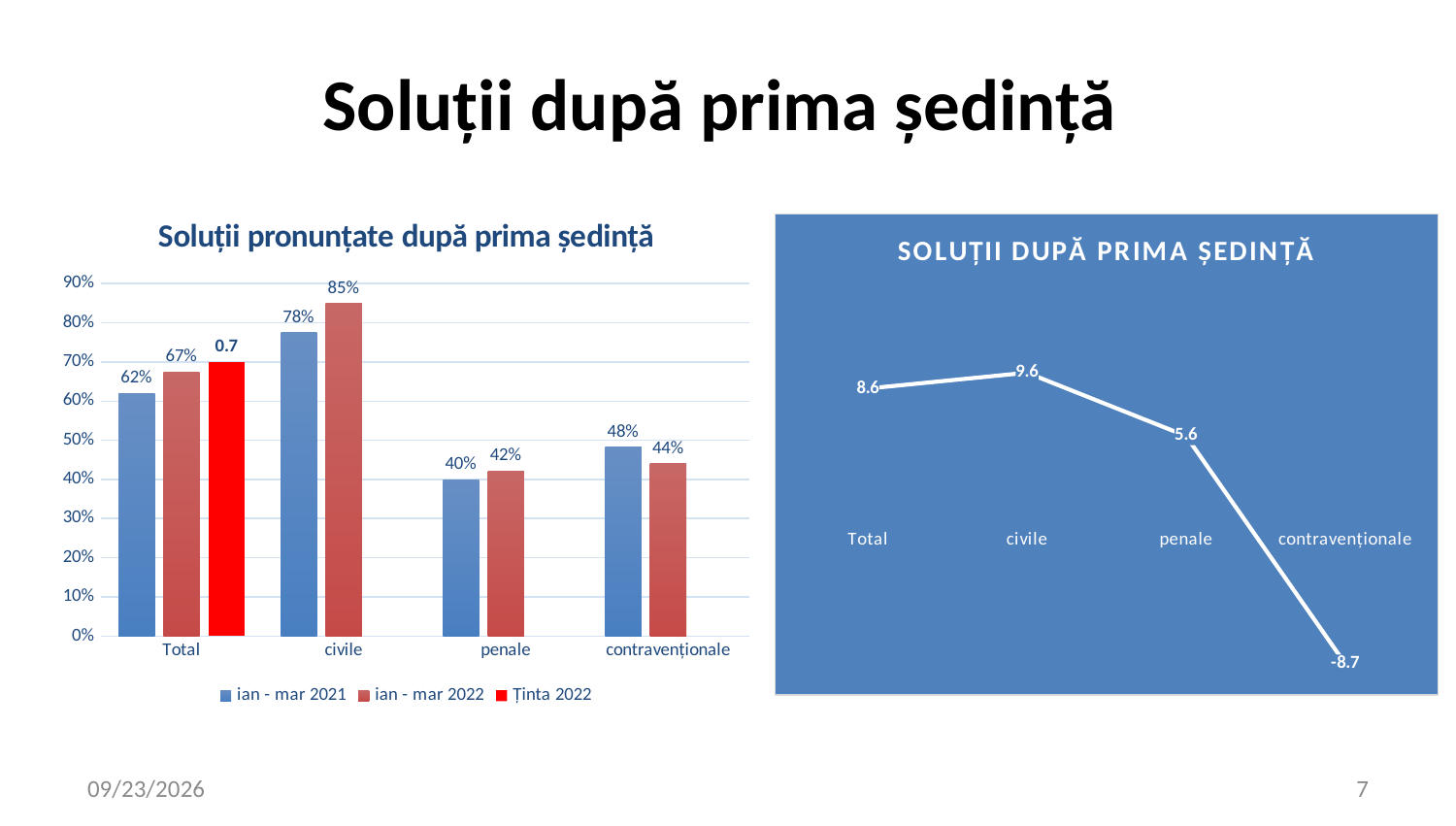
What kind of chart is the chart on the right titled 'SOLUȚII DUPĂ PRIMA ȘEDINȚĂ'? line chart In the bar chart 'Soluții pronunțate după prima ședință', what is the Ținta 2022 value shown for Total? 0.7 In the bar chart 'Soluții pronunțate după prima ședință', which category has the lowest ian - mar 2021 value? penale In the bar chart 'Soluții pronunțate după prima ședință', what is the value for penale in the ian - mar 2021 series? 40% In the bar chart 'Soluții pronunțate după prima ședință', what is the value for civile in the ian - mar 2022 series? 85% In the line chart 'SOLUȚII DUPĂ PRIMA ȘEDINȚĂ', what is the value for contravenționale? -8.7 In the bar chart 'Soluții pronunțate după prima ședință', which category has the highest ian - mar 2022 value? civile In the line chart 'SOLUȚII DUPĂ PRIMA ȘEDINȚĂ', which category has the highest value? civile How many categories are shown on the x axis of the line chart 'SOLUȚII DUPĂ PRIMA ȘEDINȚĂ'? 4 In the bar chart 'Soluții pronunțate după prima ședință', what is the difference between the ian - mar 2022 and ian - mar 2021 values for Total? 5% In the bar chart 'Soluții pronunțate după prima ședință', for contravenționale, which is larger: ian - mar 2021 or ian - mar 2022? ian - mar 2021 How many series does the legend of the bar chart 'Soluții pronunțate după prima ședință' list? 3